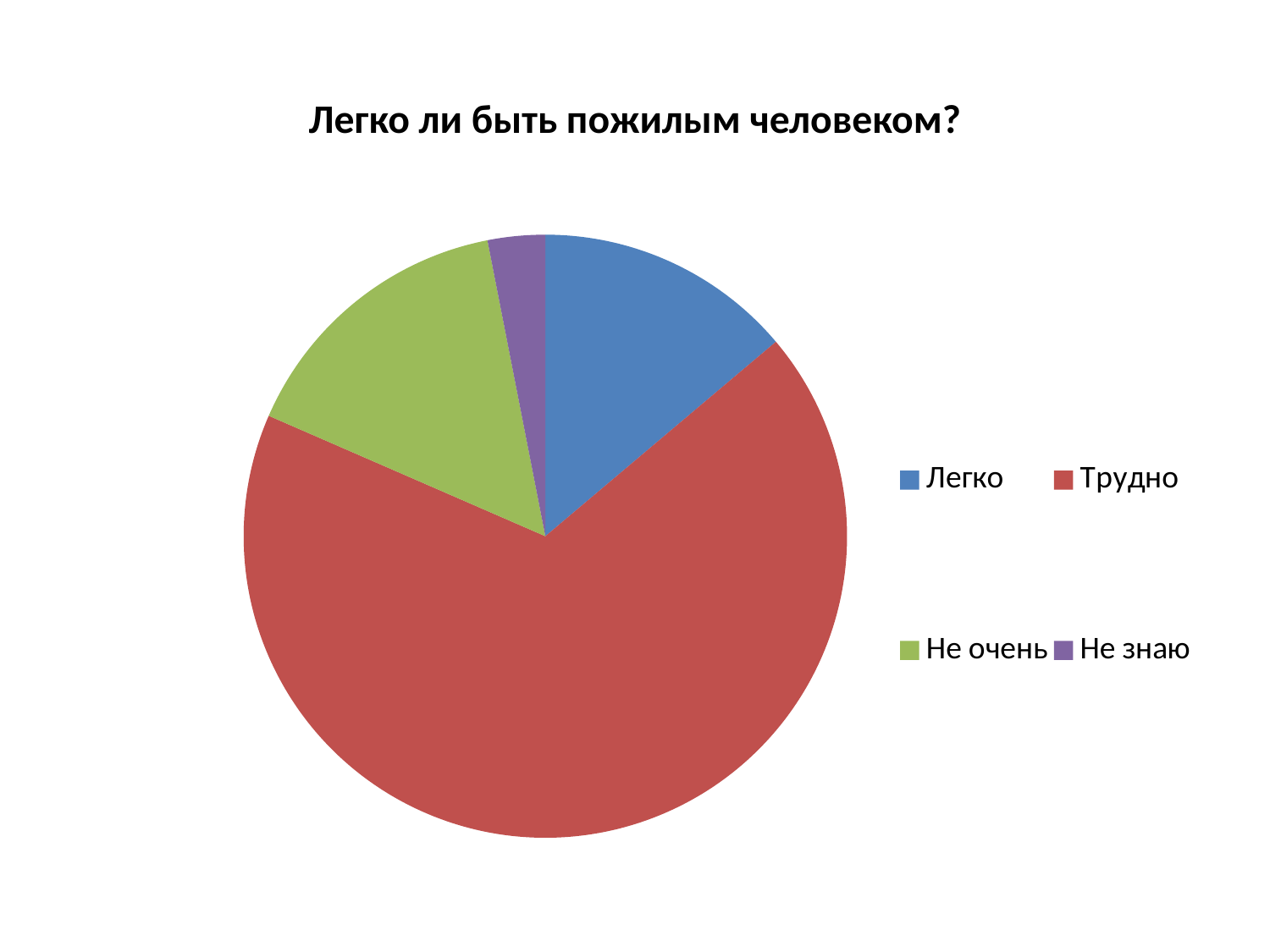
What is the title of the chart? Легко ли быть пожилым человеком? Which slice is larger, Трудно or Не очень? Трудно Which slice is larger, Легко or Не знаю? Легко Which slice is larger, Не очень or Не знаю? Не очень How many categories does the pie chart have? 4 What kind of chart is shown on the slide? pie chart What colour is the slice for Не очень? green Which category has the largest slice of the pie? Трудно Which category has the smallest slice of the pie? Не знаю